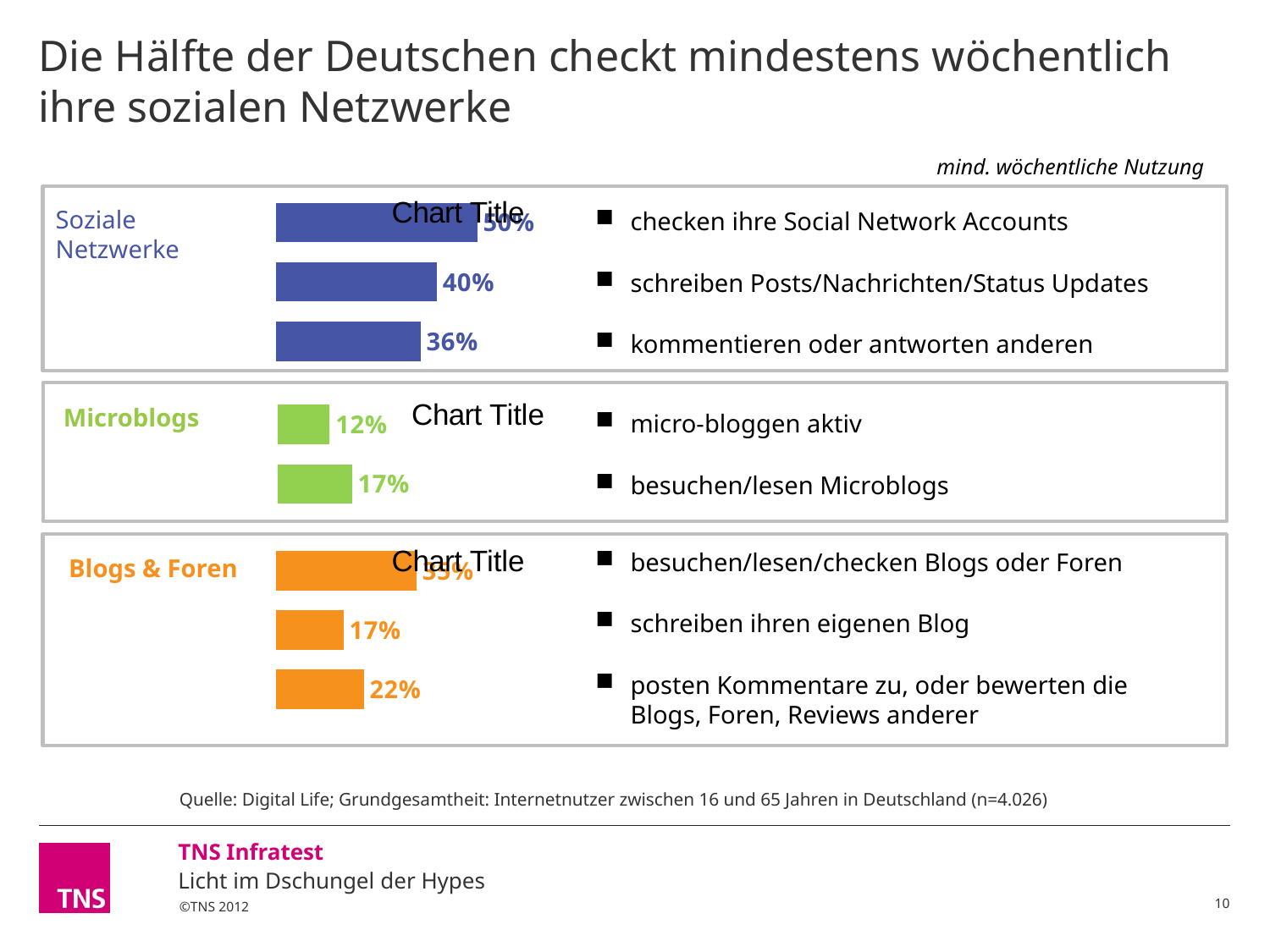
In the Blogs & Foren chart, which activity has the highest value? besuchen/lesen/checken Blogs oder Foren What kind of chart is used in the Blogs & Foren section? bar chart In the Soziale Netzwerke chart, what is the difference between "schreiben Posts/Nachrichten/Status Updates" and "kommentieren oder antworten anderen"? 4% In the Blogs & Foren chart, what is the value for "schreiben ihren eigenen Blog"? 17% In the Soziale Netzwerke chart, what is the value for "kommentieren oder antworten anderen"? 36% In the Soziale Netzwerke chart, what is the value for "schreiben Posts/Nachrichten/Status Updates"? 40% In the Blogs & Foren chart, what is the value for "posten Kommentare zu, oder bewerten die Blogs, Foren, Reviews anderer"? 22% In the Microblogs chart, what is the value for "besuchen/lesen Microblogs"? 17% In the Soziale Netzwerke chart, which activity has the highest value? checken ihre Social Network Accounts In the Microblogs chart, which is larger: "micro-bloggen aktiv" or "besuchen/lesen Microblogs"? besuchen/lesen Microblogs In the Microblogs chart, what is the value for "micro-bloggen aktiv"? 12% In the Microblogs chart, how many bars are shown? 2